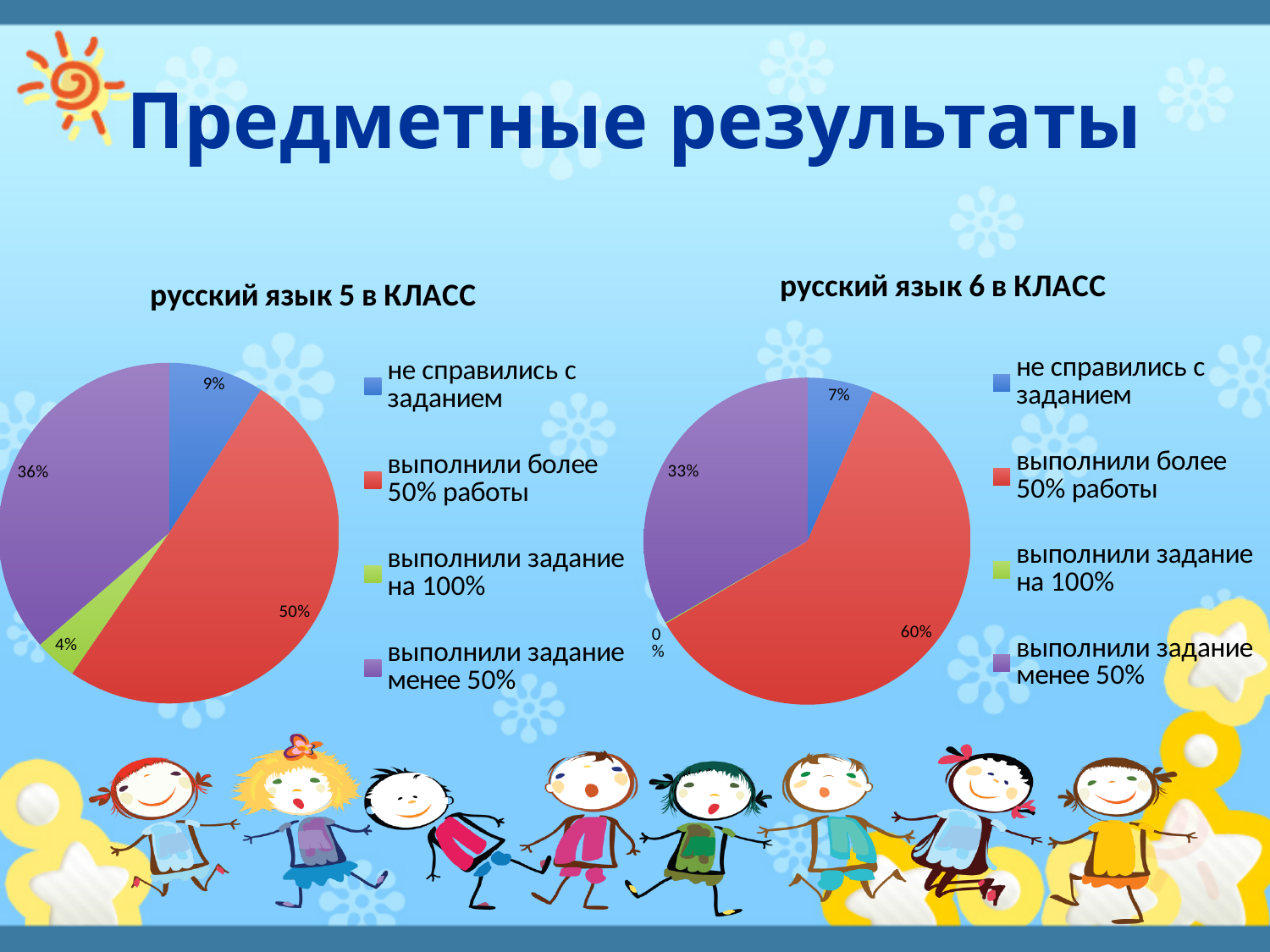
In the chart titled 'русский язык 5 в КЛАСС', what is the difference between the share for 'выполнили более 50% работы' and the share for 'выполнили задание менее 50%'? 14% What kind of chart is the chart titled 'русский язык 5 в КЛАСС'? pie chart In the chart titled 'русский язык 5 в КЛАСС', what share of students 'выполнили более 50% работы'? 50% In the chart titled 'русский язык 6 в КЛАСС', what share of students 'выполнили задание менее 50%'? 33% In the chart titled 'русский язык 6 в КЛАСС', which category has the largest slice? выполнили более 50% работы In the chart titled 'русский язык 5 в КЛАСС', which category has the smallest slice? выполнили задание на 100% How many categories does the legend of the chart titled 'русский язык 6 в КЛАСС' list? 4 In the chart titled 'русский язык 5 в КЛАСС', what share of students 'не справились с заданием'? 9% In the chart titled 'русский язык 6 в КЛАСС', what share of students 'выполнили задание на 100%'? 0% In the chart titled 'русский язык 5 в КЛАСС', what colour is the slice for 'выполнили задание на 100%'? green Which chart has the larger share for 'выполнили задание менее 50%': 'русский язык 5 в КЛАСС' or 'русский язык 6 в КЛАСС'? русский язык 5 в КЛАСС In the chart titled 'русский язык 6 в КЛАСС', what is the difference between the share for 'выполнили более 50% работы' and the share for 'не справились с заданием'? 53%